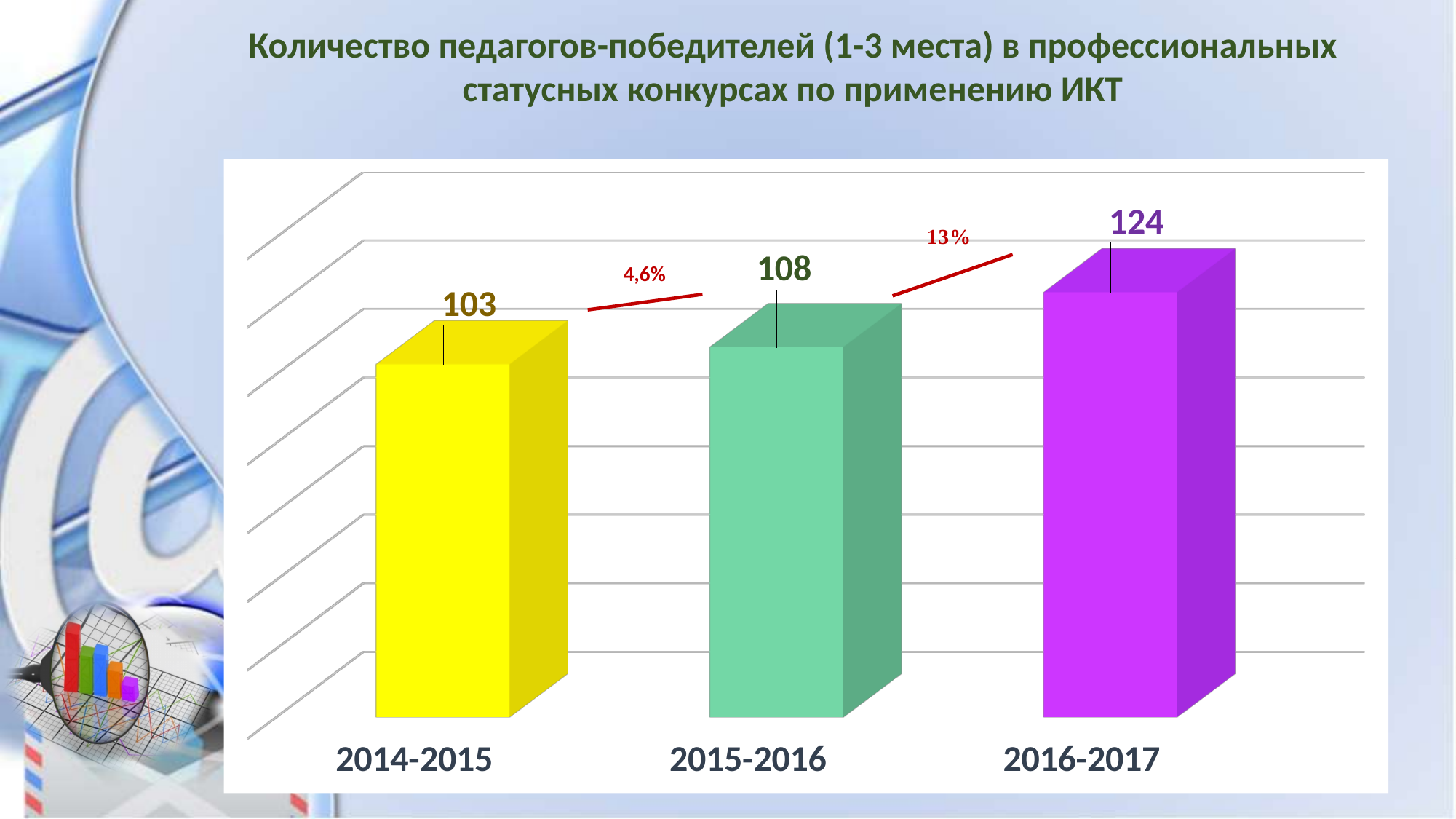
Which is larger, the value for 2015-2016 or the value for 2016-2017? 2016-2017 What is the value for 2016-2017? 124 Do the values rise or fall from 2014-2015 to 2016-2017? rise What is the difference between the values for 2015-2016 and 2014-2015? 5 What is the value for 2015-2016? 108 What kind of chart is shown on the slide? bar chart Which period has the lowest value? 2014-2015 What is the value for 2014-2015? 103 How many periods are shown on the x axis? 3 What is the difference between the values for 2016-2017 and 2014-2015? 21 Which period has the highest value? 2016-2017 What percentage increase is annotated between 2015-2016 and 2016-2017? 13%